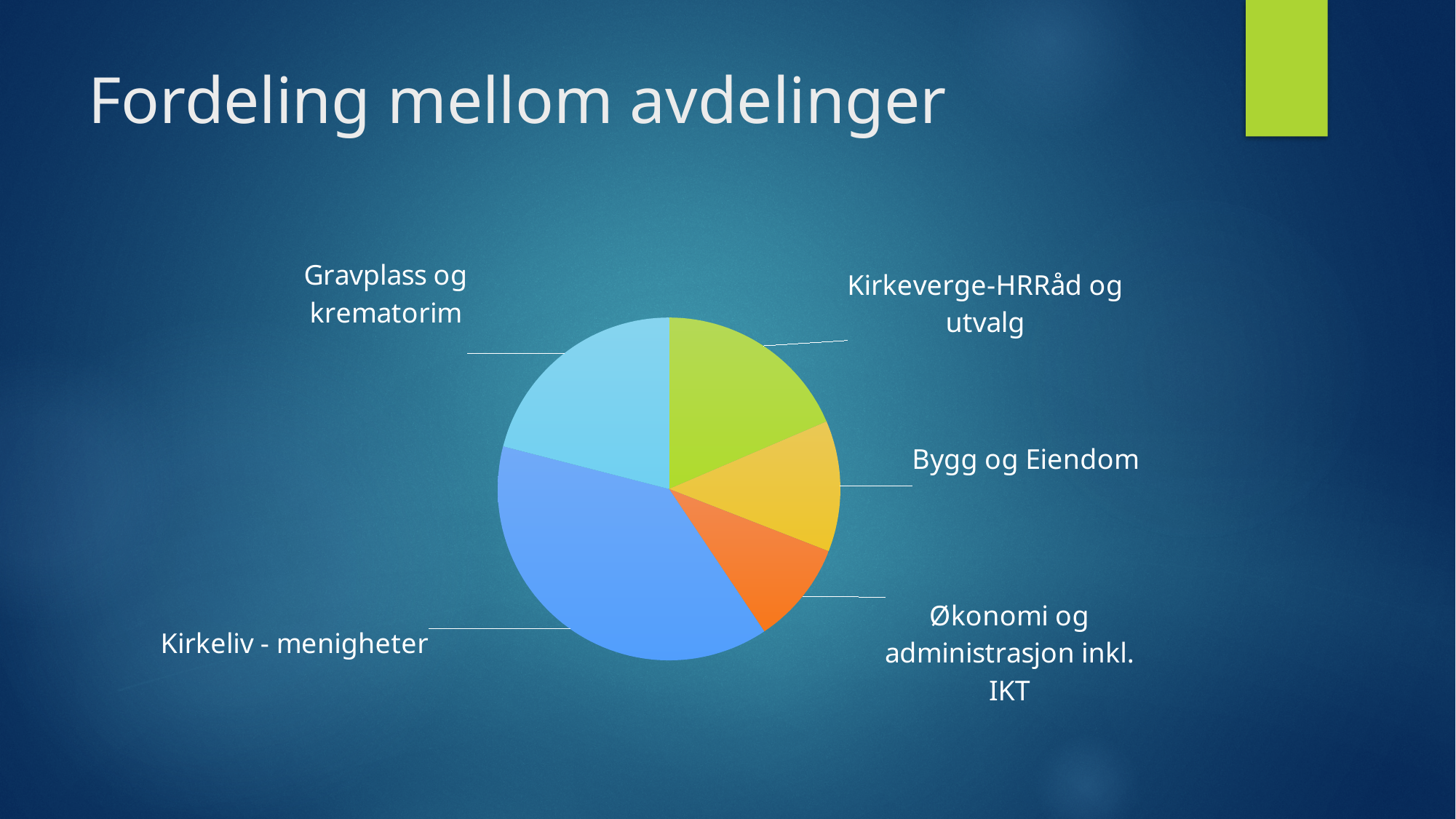
Which slice is larger: Gravplass og krematorim or Økonomi og administrasjon inkl. IKT? Gravplass og krematorim What kind of chart is shown on the slide? pie chart What colour is the slice for Bygg og Eiendom? yellow Which slice is larger: Kirkeliv - menigheter or Gravplass og krematorim? Kirkeliv - menigheter Which category has the largest slice of the pie chart? Kirkeliv - menigheter Which category has the smallest slice of the pie chart? Økonomi og administrasjon inkl. IKT How many slices does the pie chart have? 5 Which slice is larger: Gravplass og krematorim or Kirkeverge-HRRåd og utvalg? Gravplass og krematorim What is the title of the slide containing the pie chart? Fordeling mellom avdelinger